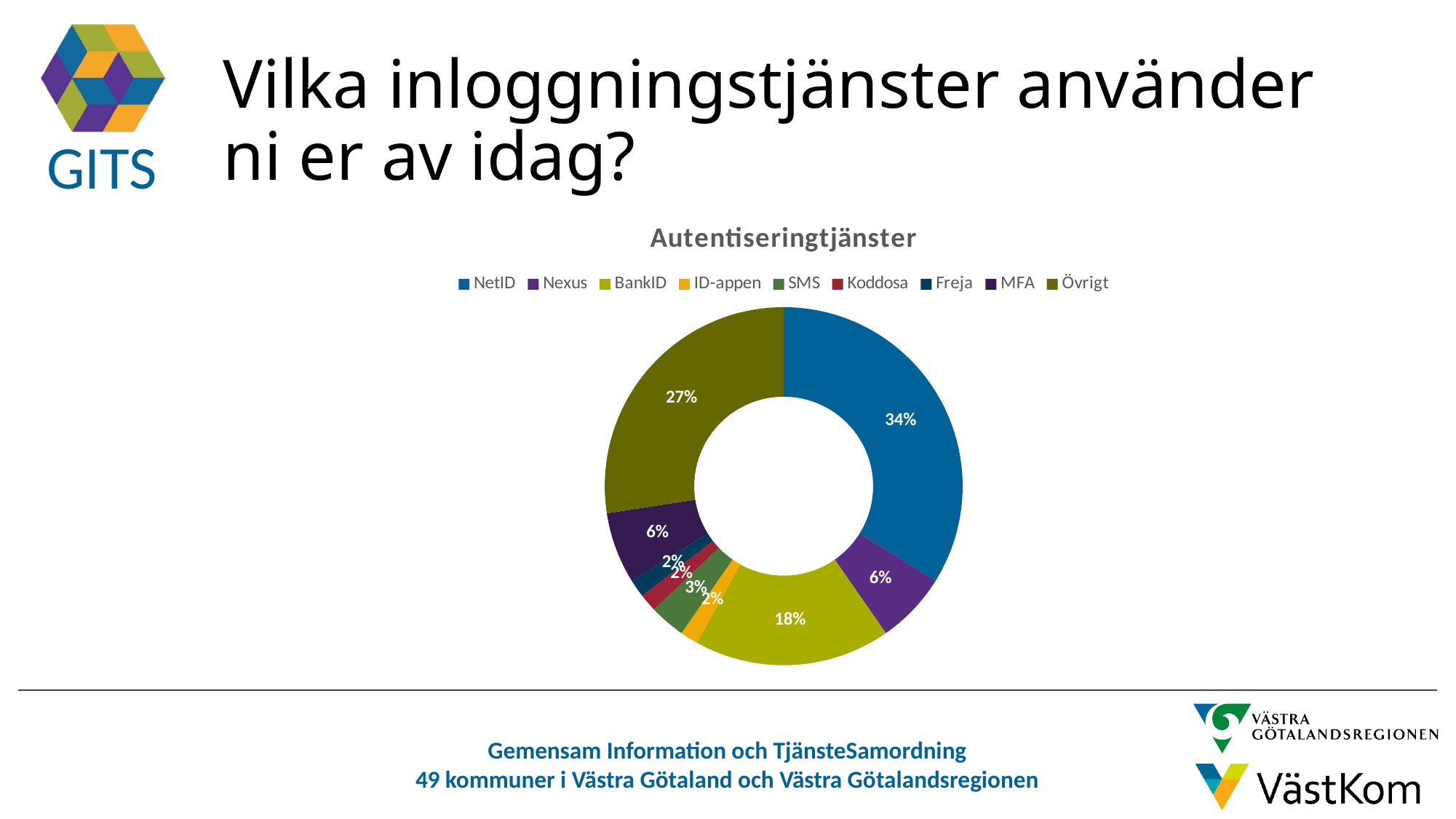
What is the difference between the shares of NetID and Övrigt? 7% Which has the larger share, BankID or Övrigt? Övrigt What share does Övrigt have? 27% What share does SMS have? 3% What share does BankID have? 18% What kind of chart is shown on the slide? Pie (doughnut) chart What is the chart's title? Autentiseringtjänster Which category has the largest share? NetID What share does NetID have? 34% How many categories does the legend list? 9 What share does MFA have? 6% What colour is the NetID slice? Blue